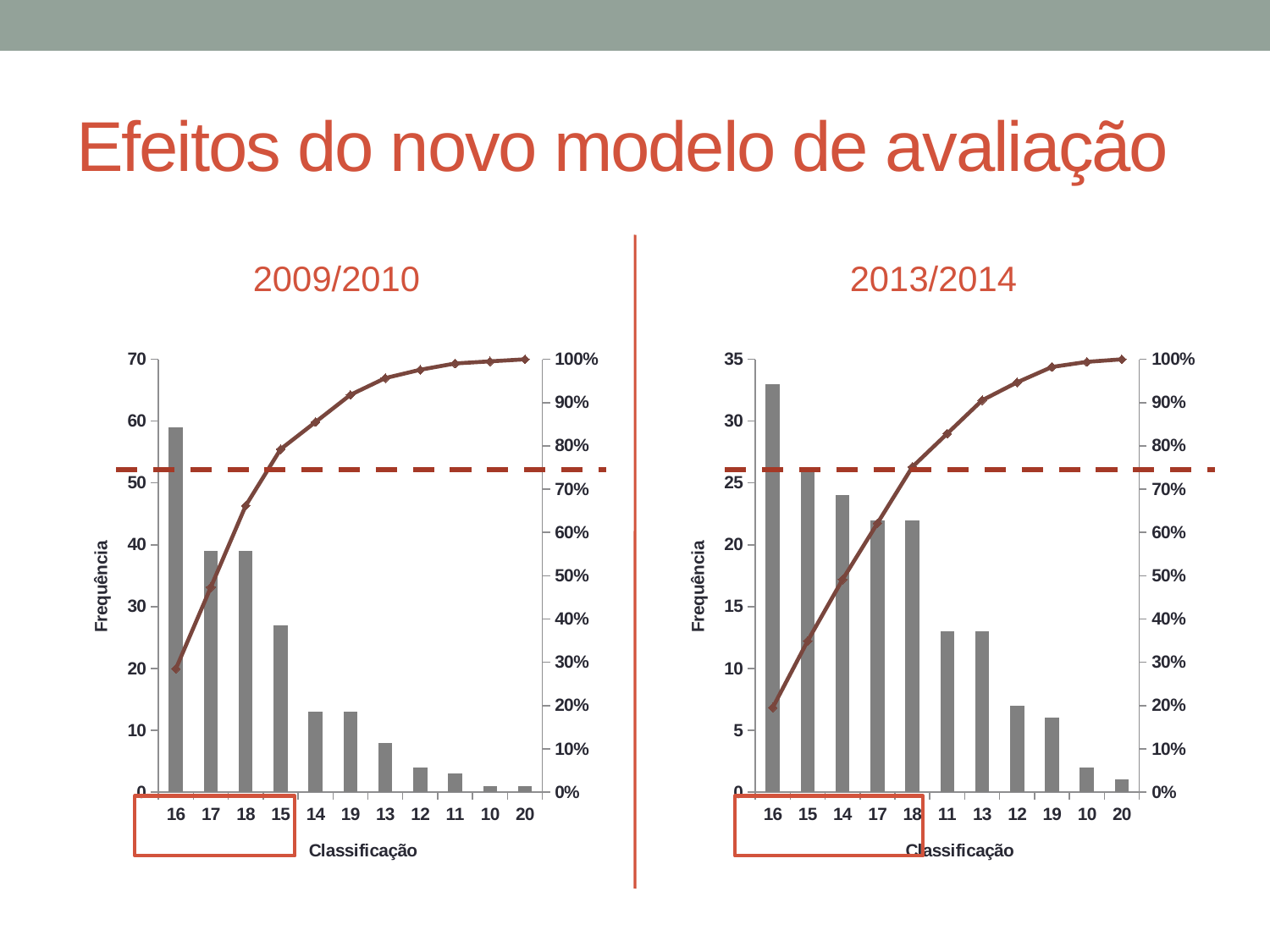
In the 2013/2014 chart, is the frequency for classification 16 greater or less than 30? greater In the 2013/2014 chart, which classification has the highest frequency? 16 In the 2009/2010 chart, is the frequency for classification 15 greater or less than 30? less In the 2009/2010 chart, which classification has the highest frequency? 16 In the 2013/2014 chart, which has the higher frequency, classification 14 or classification 11? 14 In the 2009/2010 chart, which has the higher frequency, classification 17 or classification 14? 17 In the 2013/2014 chart, is the frequency for classification 12 greater or less than 10? less In the 2013/2014 chart, does the cumulative percentage line rise or fall from left to right? rise How many classification categories are shown on the x axis of the 2009/2010 chart? 11 How many classification categories are shown on the x axis of the 2013/2014 chart? 11 What is the label of the left vertical axis on the 2009/2010 chart? Frequência